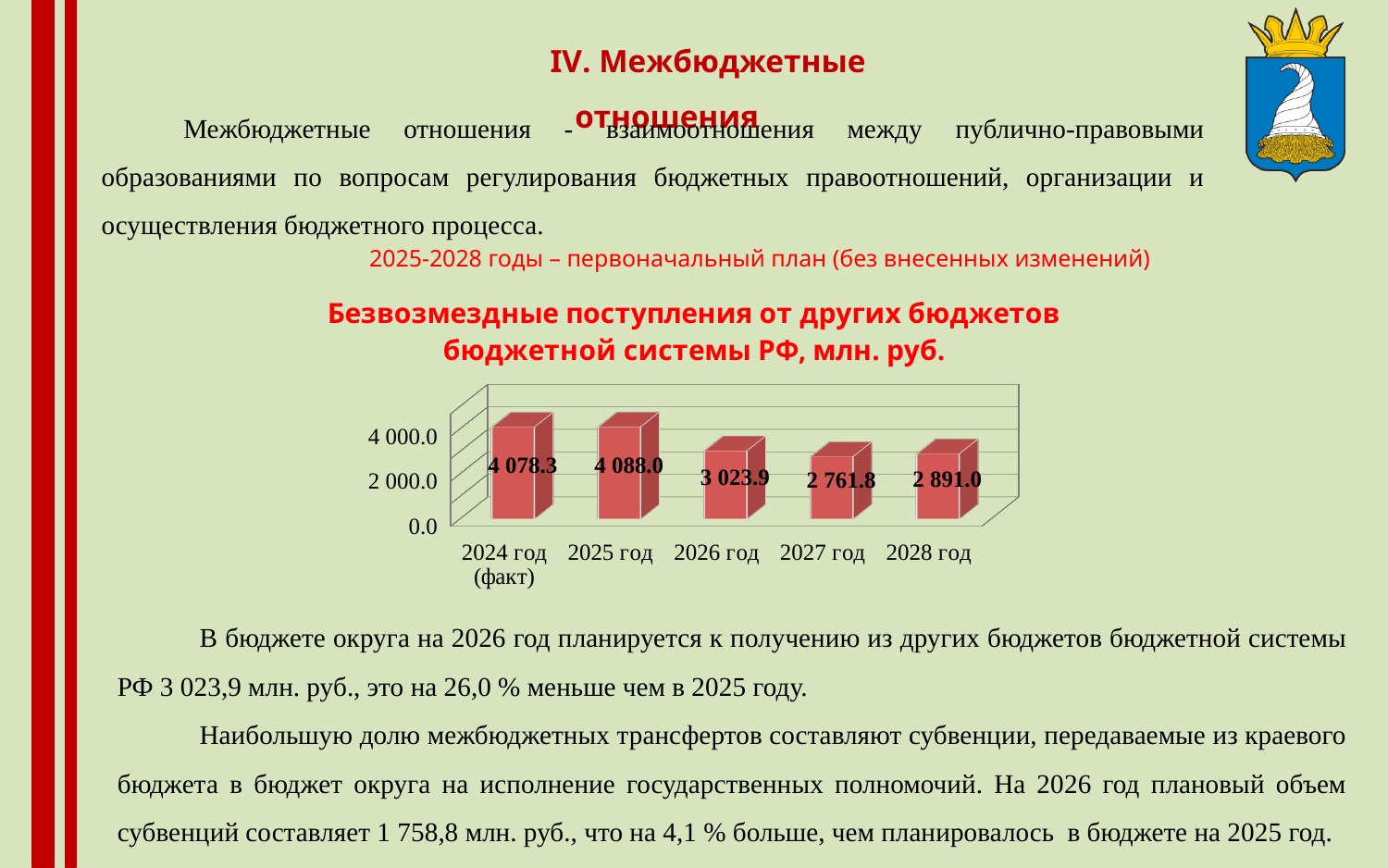
Which is larger, the value for 2026 год or the value for 2028 год? 2026 год Is the value for 2027 год greater or less than 4 000.0? less Which year has the lowest value in the chart? 2027 год What unit is given in the chart title? млн. руб. What kind of chart is shown on the slide? bar chart How many years are shown in the chart? 5 What is the value for 2026 год in the chart? 3 023.9 What is the value for 2027 год in the chart? 2 761.8 What is the difference between the values for 2025 год and 2026 год? 1 064.1 What is the difference between the values for 2028 год and 2027 год? 129.2 What is the value for 2024 год (факт) in the chart? 4 078.3 What is the value for 2028 год in the chart? 2 891.0